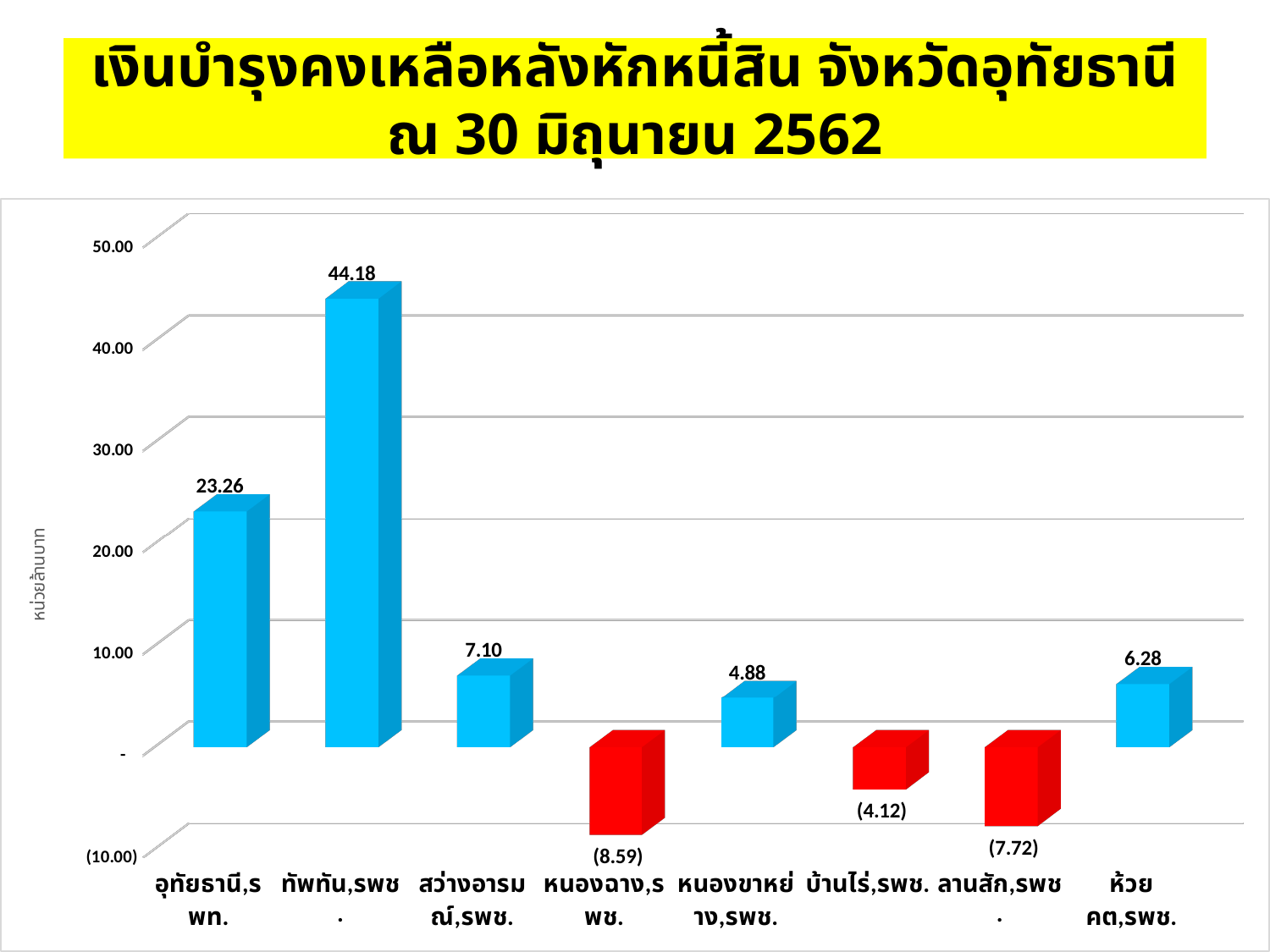
What unit is given on the vertical axis label? หน่วยล้านบาท What is the difference between the values for ทัพทัน,รพช. and อุทัยธานี,รพท.? 20.92 How many categories are shown on the x axis? 8 What is the value for อุทัยธานี,รพท.? 23.26 Which category has the lowest value? หนองฉาง,รพช. How many bars are shown in red? 3 What kind of chart is shown on the slide? bar chart Which is larger, the value for สว่างอารมณ์,รพช. or the value for ห้วยคต,รพช.? สว่างอารมณ์,รพช. What value is labelled on the bar for หนองฉาง,รพช.? (8.59) What value is labelled on the bar for ลานสัก,รพช.? (7.72) What is the value for ทัพทัน,รพช.? 44.18 Which category has the highest value? ทัพทัน,รพช.